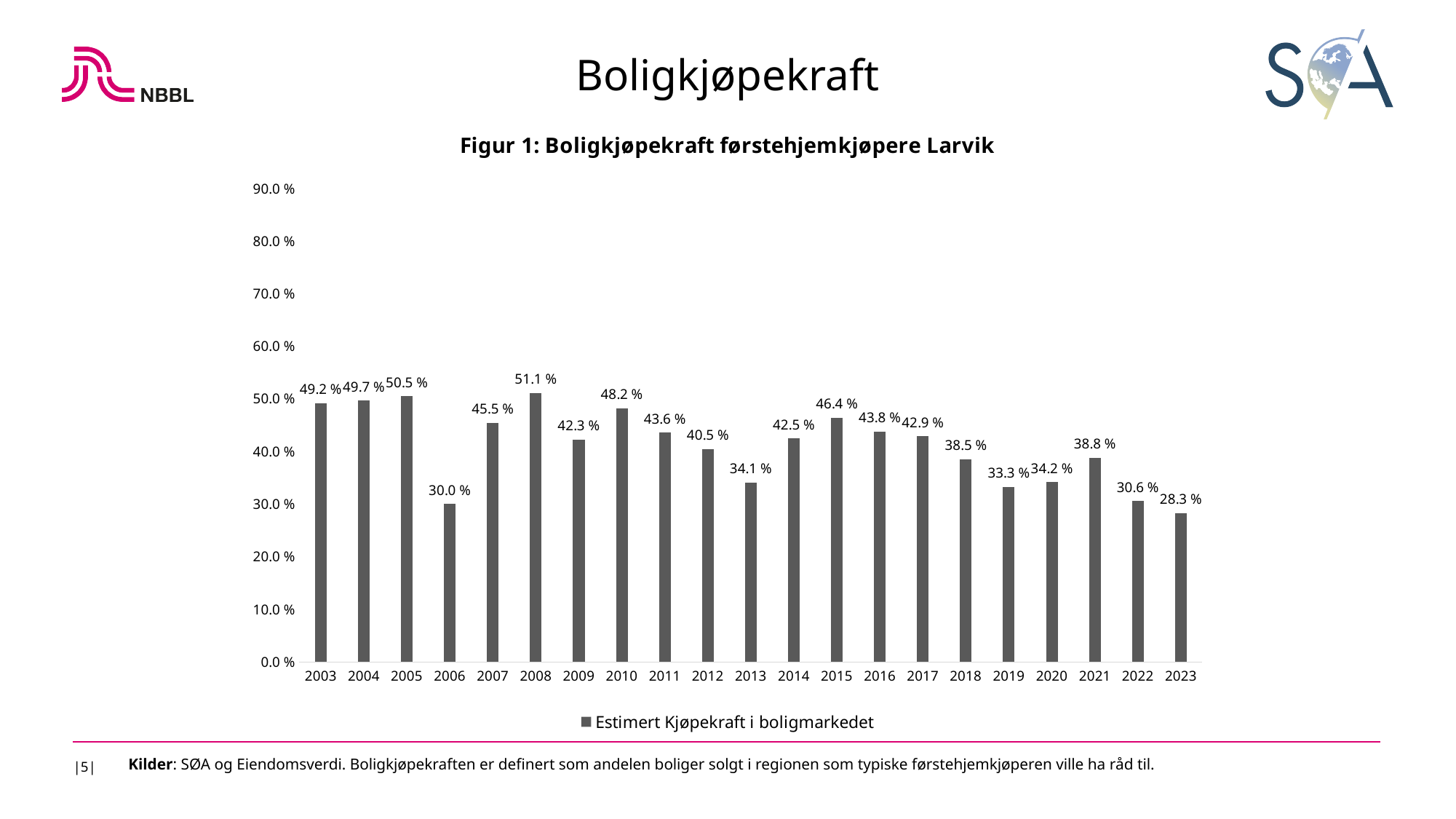
Which year has the highest value? 2008 What kind of chart is shown? bar chart Which is larger, the value for 2015 or the value for 2016? 2015 Which year has the lowest value? 2023 What is the difference between the values for 2022 and 2023? 2.3 % What is the value for 2023? 28.3 % What is the value for 2006? 30.0 % What is the difference between the values for 2005 and 2006? 20.5 % How many series does the legend list? 1 What is the value for 2008? 51.1 % How many years are shown on the x axis? 21 Is the value for 2013 greater or less than 40.0 %? less